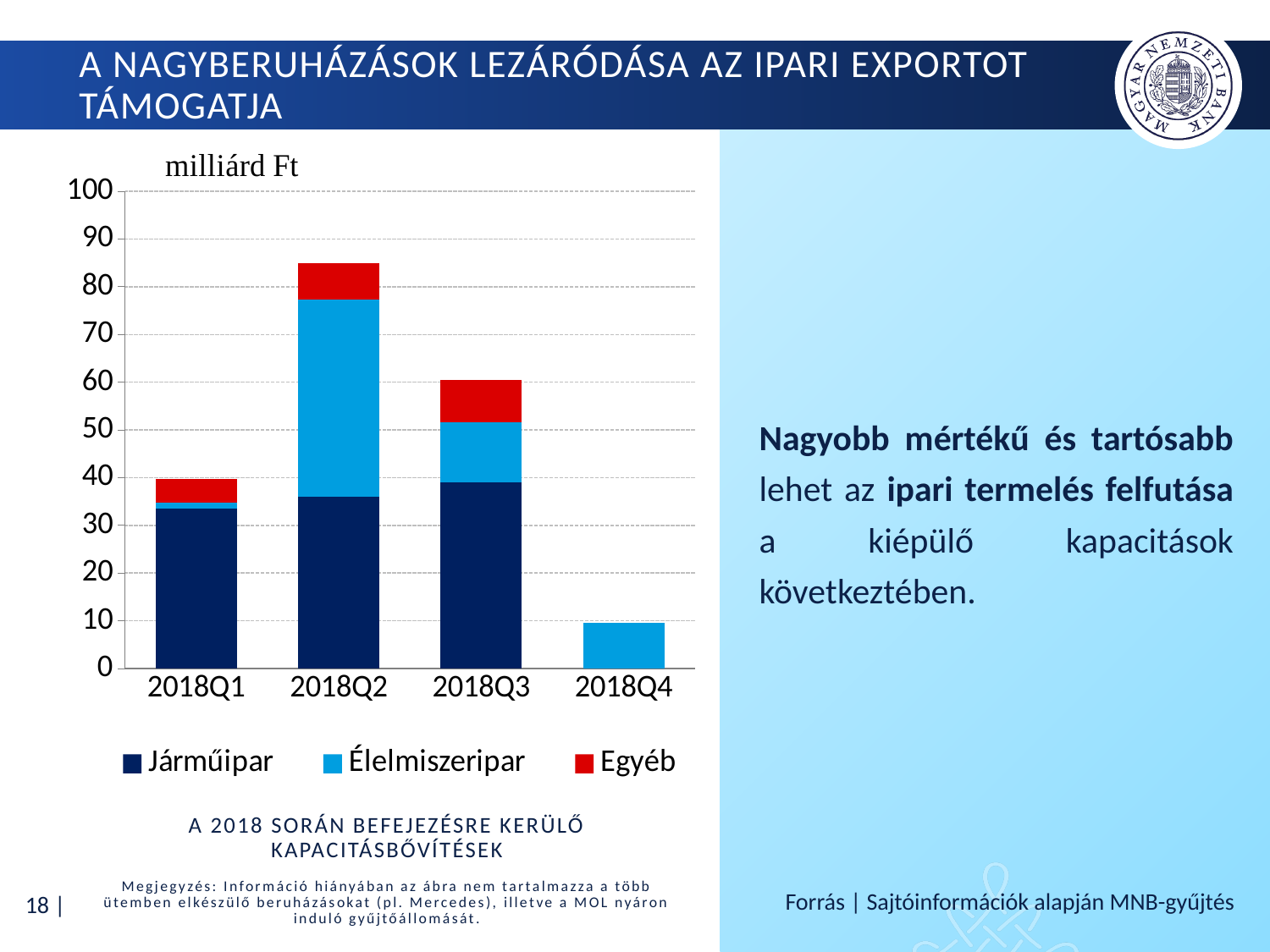
In which quarter is the Élelmiszeripar segment the largest? 2018Q2 Which quarter has the larger total bar, 2018Q1 or 2018Q3? 2018Q3 How many quarters are shown on the x axis of the chart? 4 Is the total bar for 2018Q1 greater or less than 30? greater Which quarter has the lowest total bar in the chart? 2018Q4 How many series does the chart's legend list? 3 What unit is shown above the y axis of the chart? milliárd Ft Is the total bar for 2018Q2 greater or less than 80? greater What kind of chart is shown on the slide? Stacked bar chart Is the total bar for 2018Q3 greater or less than 70? less Which quarter has the highest total bar in the chart? 2018Q2